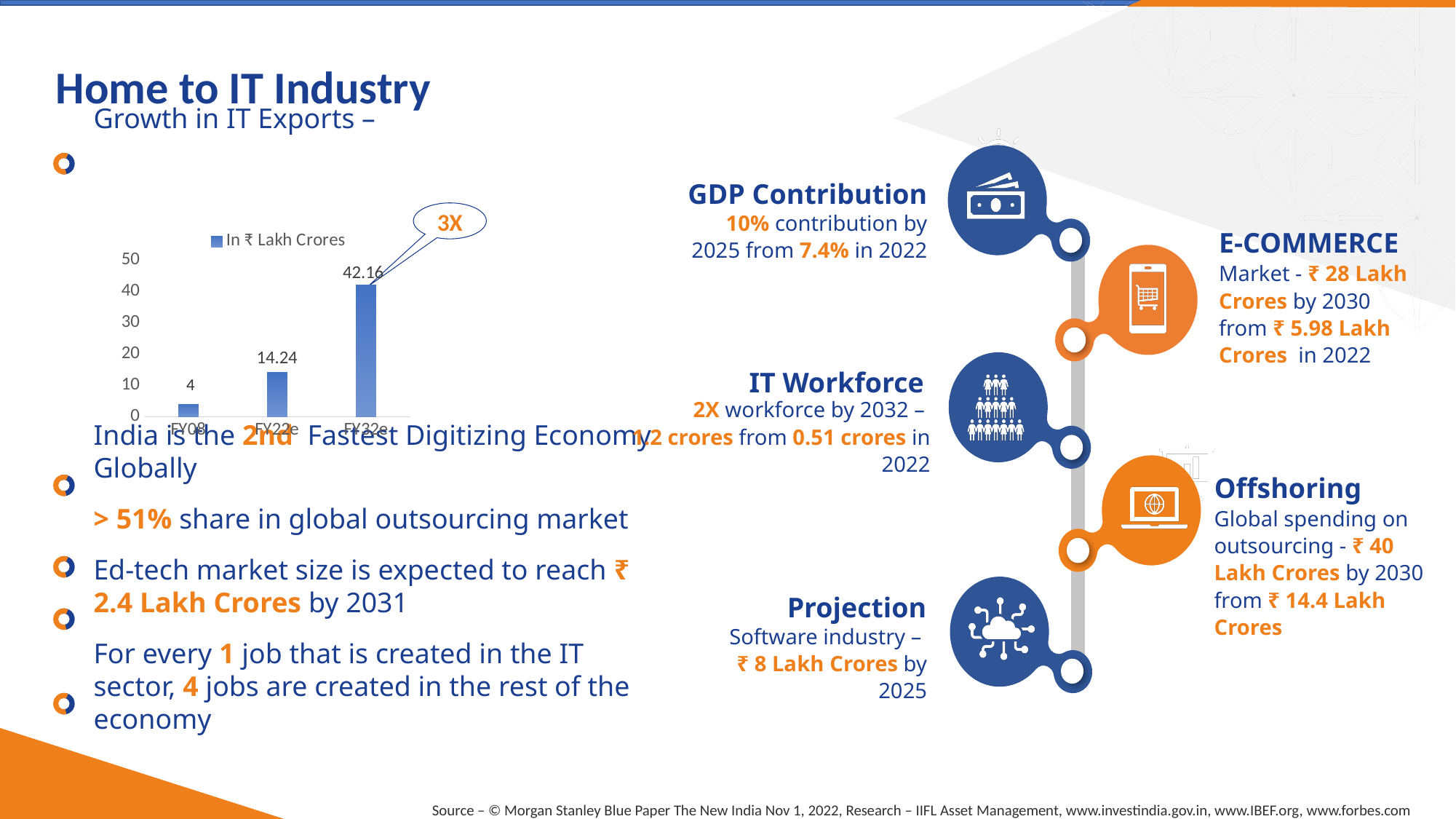
In the Growth in IT Exports chart, what is the value of the middle bar? 14.24 In the Growth in IT Exports chart, what is the value of the tallest bar? 42.16 In the Growth in IT Exports chart, what is the value of the first (leftmost) bar? 4 How many bars are plotted in the Growth in IT Exports chart? 3 What unit does the legend of the Growth in IT Exports chart give for the values? In ₹ Lakh Crores In the Growth in IT Exports chart, what is the difference between the third bar (42.16) and the second bar (14.24)? 27.92 What type of chart is shown under 'Growth in IT Exports'? bar chart Do the values in the Growth in IT Exports chart rise or fall from left to right? rise In the Growth in IT Exports chart, what is the difference between the second bar (14.24) and the first bar (4)? 10.24 How many series does the legend of the Growth in IT Exports chart list? 1 In the Growth in IT Exports chart, what is the value of the shortest bar? 4 In the Growth in IT Exports chart, which is larger: the first bar or the middle bar? the middle bar